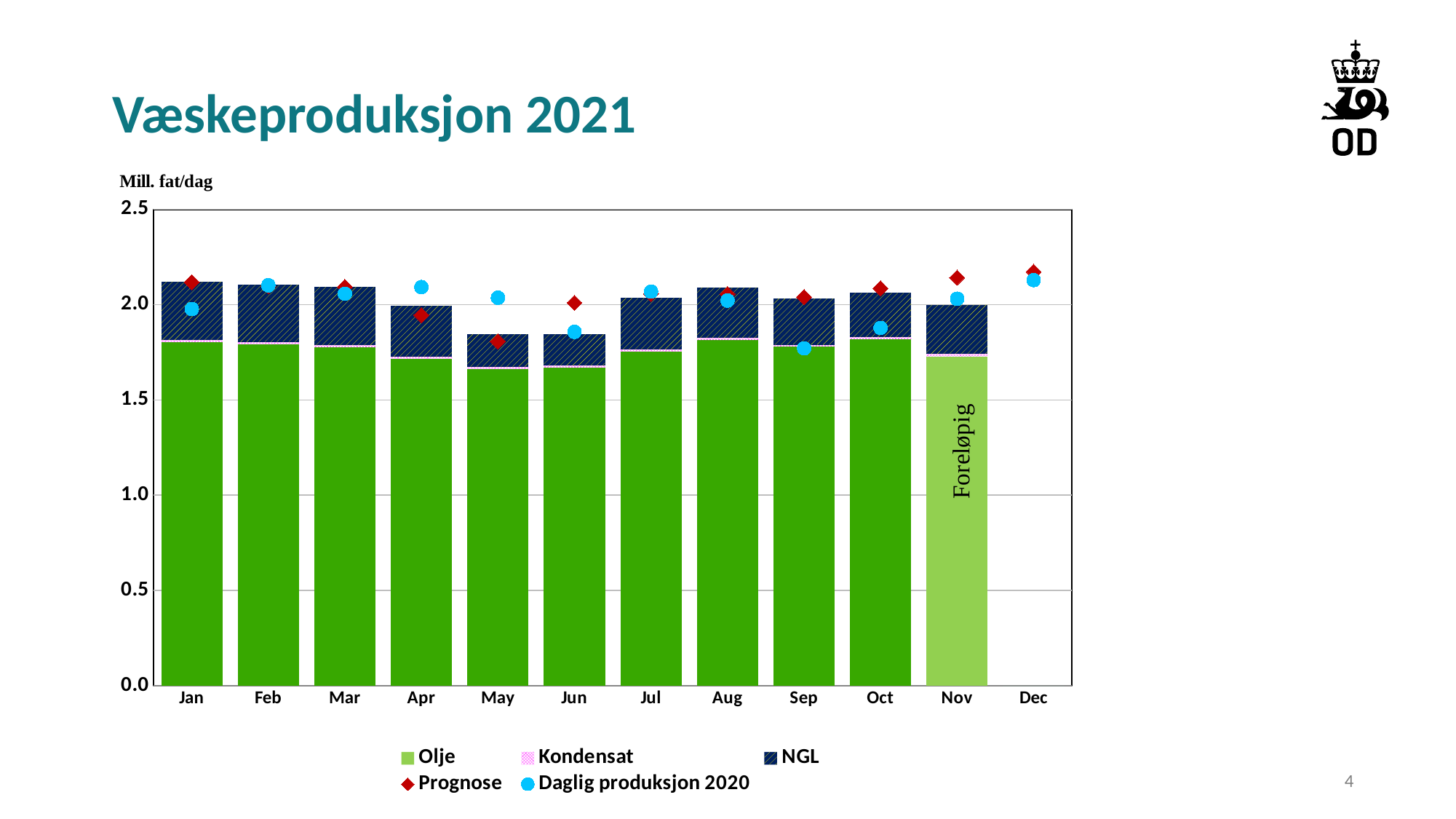
Is the Olje value for Jan greater or less than 1.5? greater Is the total stacked value for Jan greater or less than 2.0? greater How many months are shown on the x axis? 12 Is the total stacked value for Aug greater or less than 2.0? greater What unit is shown above the y axis? Mill. fat/dag Which has the larger total stacked value, Jan or May? Jan What kind of chart is shown on the slide? Stacked bar chart with point markers (combination chart) Which month's bar is labelled "Foreløpig"? Nov How many series does the legend list? 5